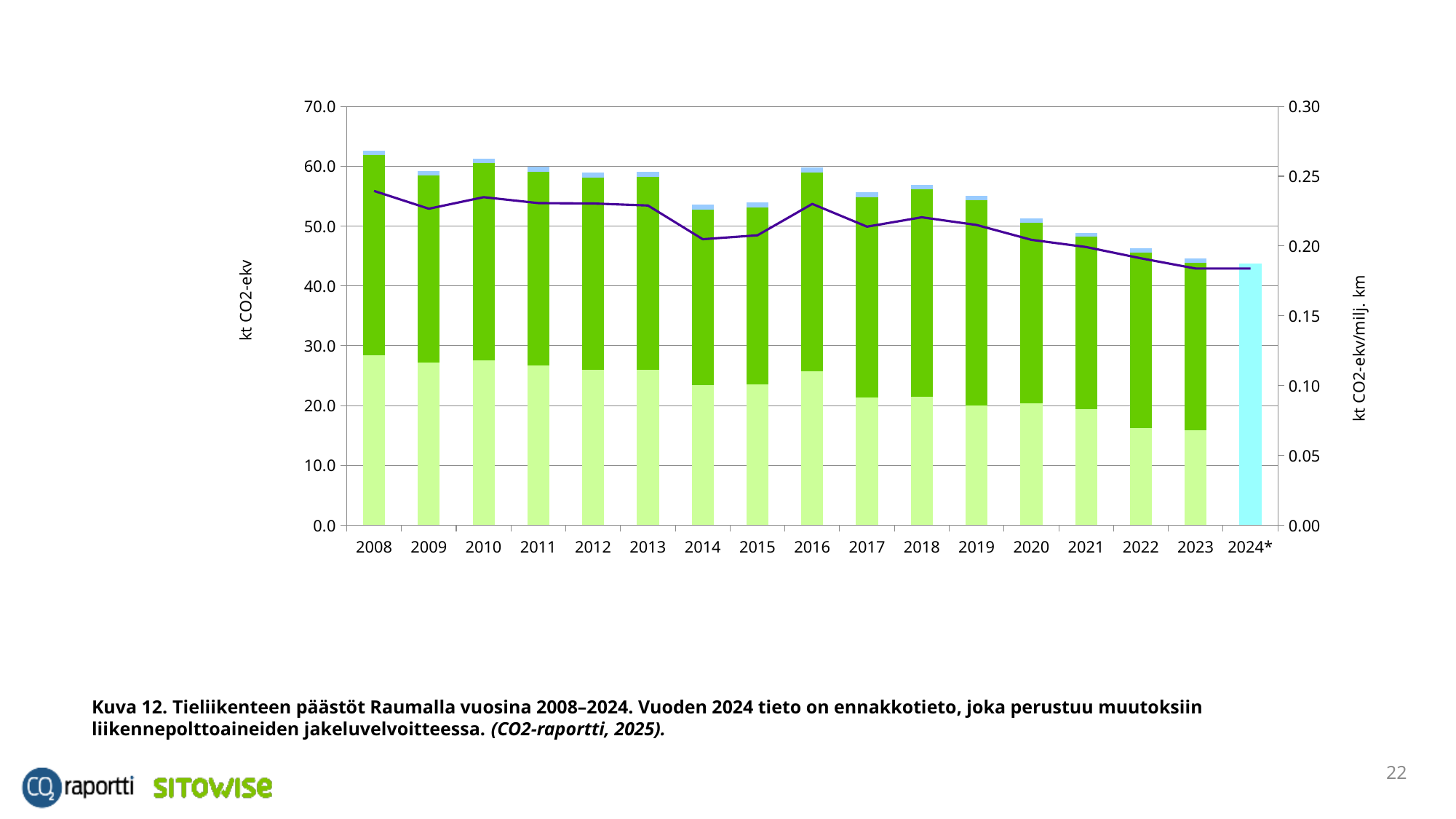
Do the total bar values generally rise or fall from 2008 to 2024*? fall What is the label of the right vertical axis? kt CO2-ekv/milj. km Is the total bar value for 2016 greater or less than 50? greater Is the total bar value for 2008 greater or less than 60? greater Which year has the larger total bar, 2008 or 2023? 2008 What kind of chart is shown on the slide? A stacked bar chart with a line How many years are shown on the x axis of the chart? 17 Is the line value for 2023 on the right axis greater or less than 0.20? less Which year has the tallest stacked bar in the chart? 2008 What is the label of the left vertical axis? kt CO2-ekv